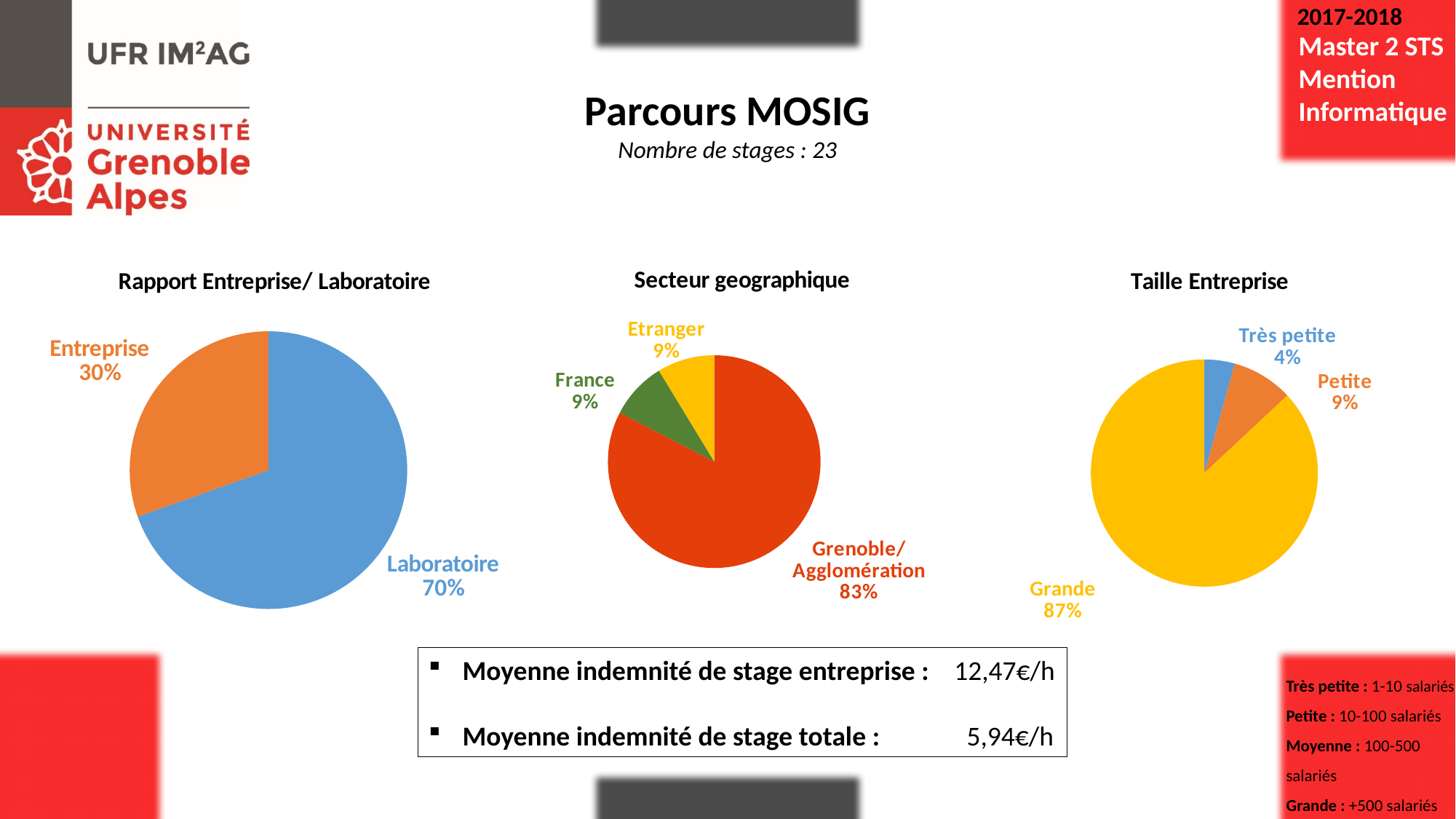
In the 'Taille Entreprise' chart, which category has the smallest share? Très petite In the 'Secteur geographique' chart, what share does France have? 9% In the 'Rapport Entreprise/ Laboratoire' chart, what share does Laboratoire have? 70% In the 'Taille Entreprise' chart, which is larger, Petite or Très petite? Petite In the 'Secteur geographique' chart, which category has the largest share? Grenoble/Agglomération In the 'Taille Entreprise' chart, what colour is the Grande slice? Yellow In the 'Taille Entreprise' chart, what share does Grande have? 87% In the 'Rapport Entreprise/ Laboratoire' chart, what share does Entreprise have? 30% In the 'Secteur geographique' chart, what share does Grenoble/Agglomération have? 83% In the 'Secteur geographique' chart, how many categories are shown? 3 What kind of chart is the 'Taille Entreprise' chart? Pie chart In the 'Rapport Entreprise/ Laboratoire' chart, what is the difference between the Laboratoire and Entreprise shares? 40%